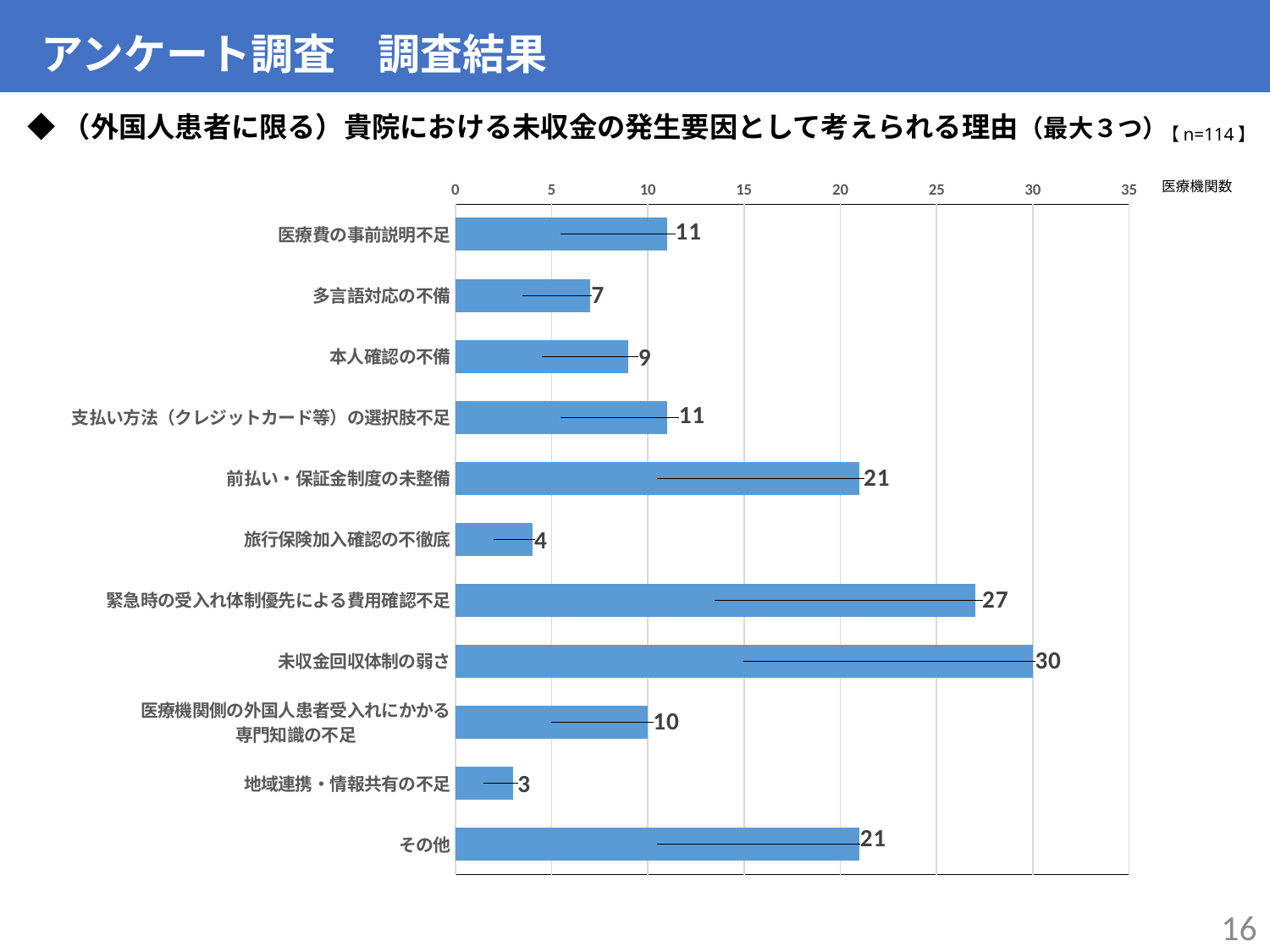
How many categories are shown in the chart? 11 Which is larger, 本人確認の不備 or 多言語対応の不備? 本人確認の不備 What is the sample size (n) shown on the slide? n=114 What is the value for 旅行保険加入確認の不徹底? 4 What is the value for 未収金回収体制の弱さ? 30 Is the value for 緊急時の受入れ体制優先による費用確認不足 greater or less than 25? greater What is the difference between 未収金回収体制の弱さ and 緊急時の受入れ体制優先による費用確認不足? 3 What kind of chart is shown on the slide? bar chart Which category has the lowest value? 地域連携・情報共有の不足 What is the value for 前払い・保証金制度の未整備? 21 What is the difference between 医療費の事前説明不足 and 地域連携・情報共有の不足? 8 Which category has the highest value? 未収金回収体制の弱さ